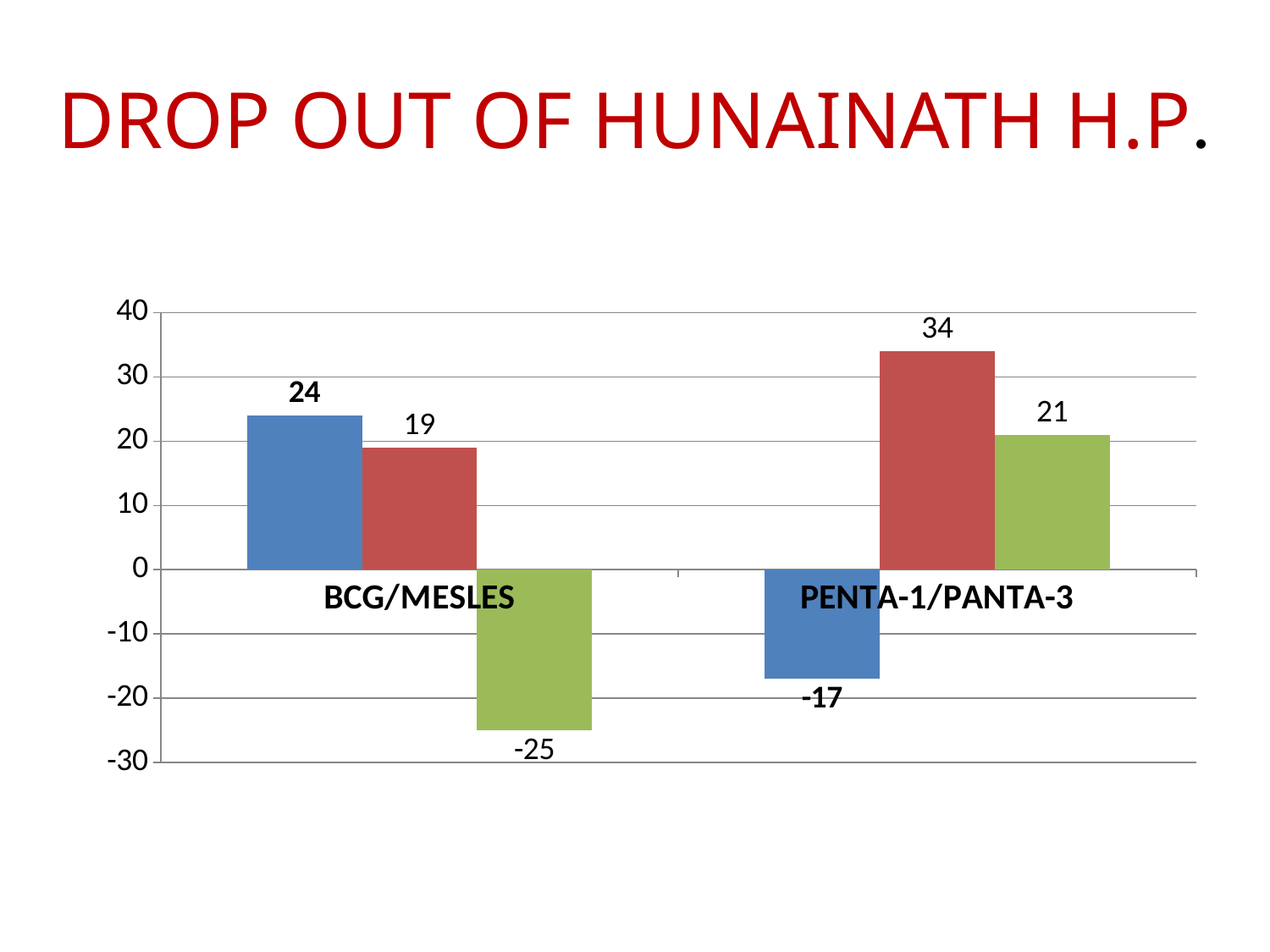
Which bar has the lowest value in the chart? the green bar for BCG/MESLES (-25) Which bar has the highest value in the chart? the red bar for PENTA-1/PANTA-3 (34) What is the title of the slide? DROP OUT OF HUNAINATH H.P. What kind of chart is shown on the slide? bar chart What is the difference between the red bar for PENTA-1/PANTA-3 and the red bar for BCG/MESLES? 15 What is the value of the red bar for PENTA-1/PANTA-3? 34 Which is larger: the blue bar for BCG/MESLES or the green bar for PENTA-1/PANTA-3? the blue bar for BCG/MESLES What is the value of the blue bar for PENTA-1/PANTA-3? -17 What is the value of the blue bar for BCG/MESLES? 24 What is the value of the green bar for BCG/MESLES? -25 How many categories are shown on the x axis of the chart? 2 What is the value of the red bar for BCG/MESLES? 19